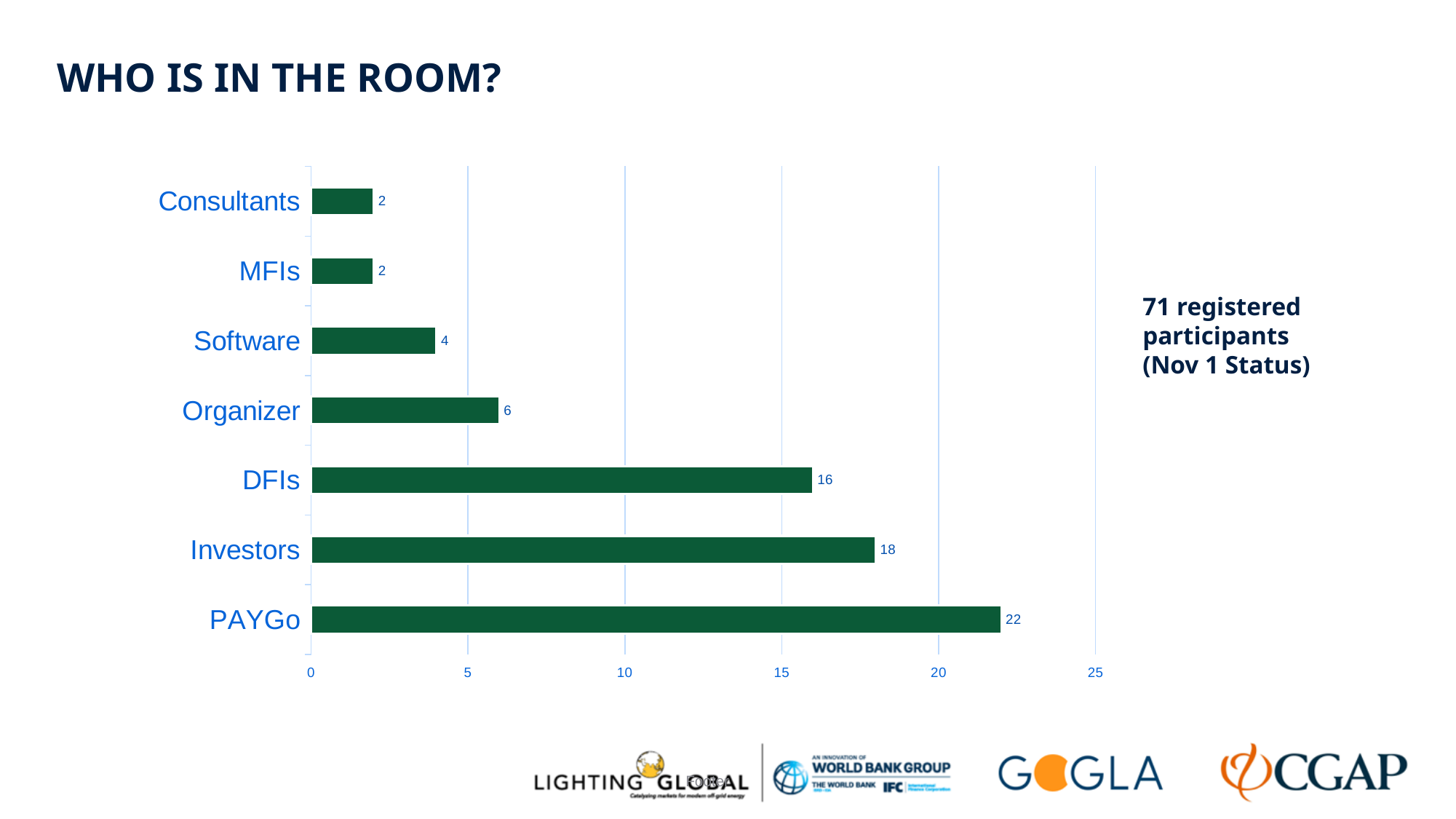
What is the difference between the values for DFIs and Software? 12 What is the title of the slide containing the chart? WHO IS IN THE ROOM? What kind of chart is shown on the slide? Bar chart Which category has the lowest value, Software or Organizer? Software What is the value for DFIs? 16 What is the value for Organizer? 6 What is the value for PAYGo? 22 Which is larger, the value for Investors or the value for DFIs? Investors How many categories are shown in the chart? 7 Is the value for DFIs greater or less than 15? greater Which category has the highest value? PAYGo What is the difference between the values for PAYGo and Investors? 4